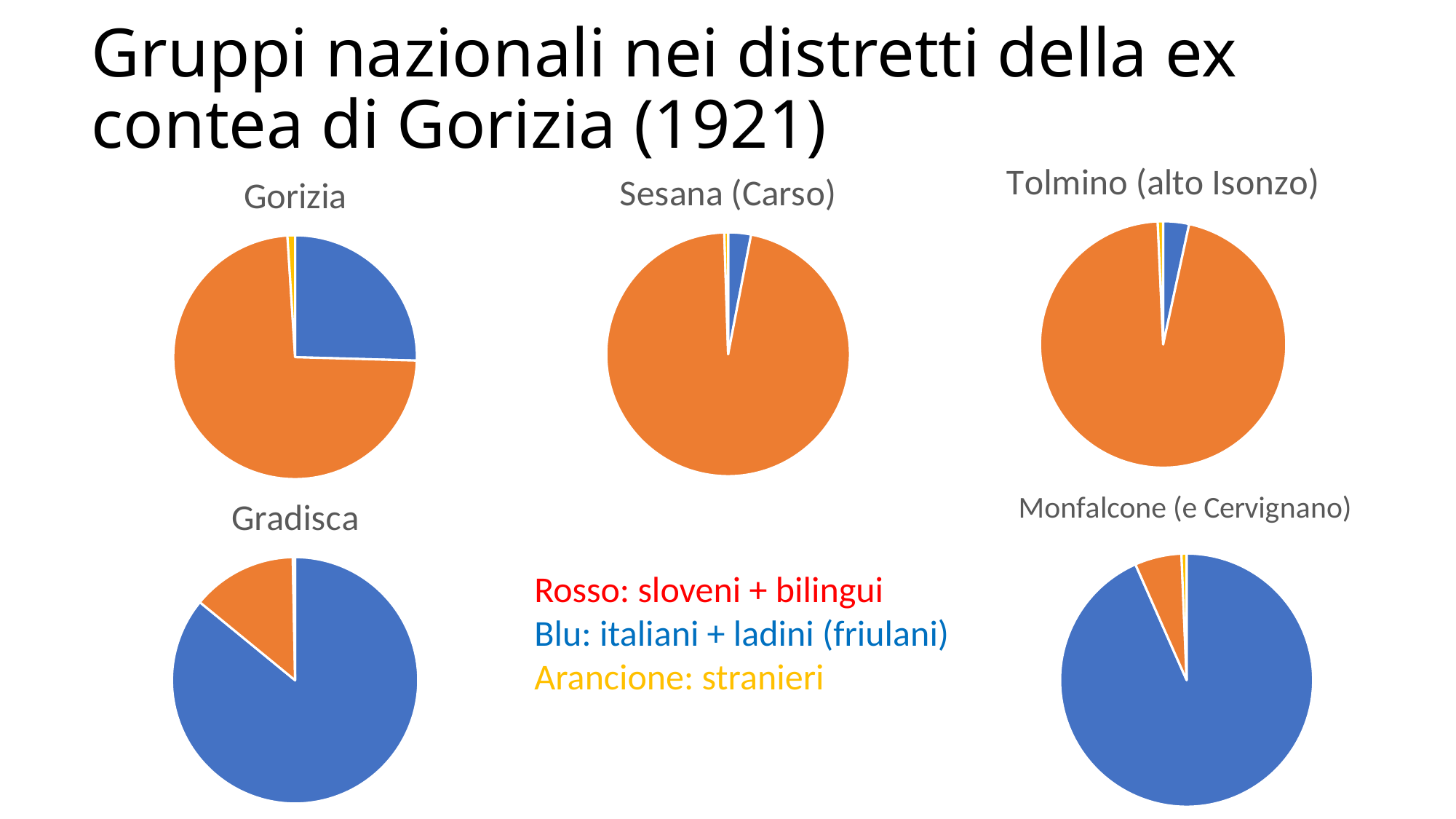
In the Sesana (Carso) chart, which colour slice is the largest? orange How many pie charts are shown on the slide? 5 What are the titles of the three charts in the top row of the slide? Gorizia, Sesana (Carso), Tolmino (alto Isonzo) In the Gorizia chart, which slice is larger, the blue one or the orange one? orange In the Gorizia chart, which colour slice is the largest? orange What kind of chart is the Gorizia chart? pie chart In the Gorizia chart, which colour slice is the smallest? yellow In the Gradisca chart, which colour slice is the largest? blue In the Monfalcone (e Cervignano) chart, which slice is larger, the blue one or the orange one? blue According to the text legend on the slide, what group does blue represent? italiani + ladini (friulani)